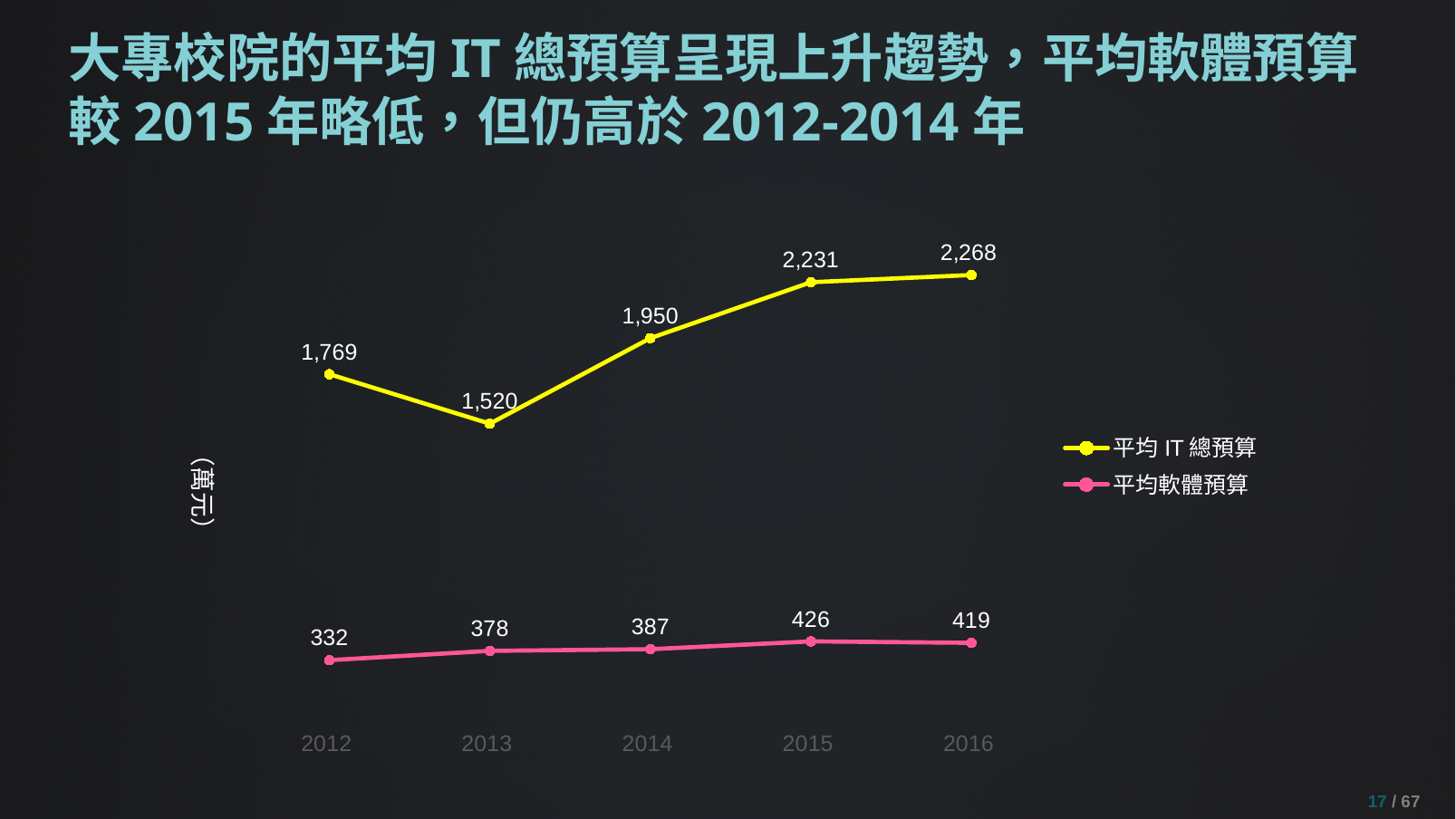
In which year is 平均 IT 總預算 the lowest? 2013 What is the difference between 平均 IT 總預算 in 2016 and in 2012? 499 How many series does the legend list? 2 In which year is 平均軟體預算 the highest? 2015 What unit is shown on the vertical axis label? 萬元 How many years are shown on the x axis? 5 Does 平均 IT 總預算 rise or fall from 2013 to 2016? Rise What is the difference between 平均軟體預算 in 2015 and in 2016? 7 What kind of chart is shown on the slide? Line chart Which is larger: 平均 IT 總預算 in 2012 or in 2013? 2012 What is the value of 平均 IT 總預算 in 2014? 1,950 What is the value of 平均軟體預算 in 2015? 426